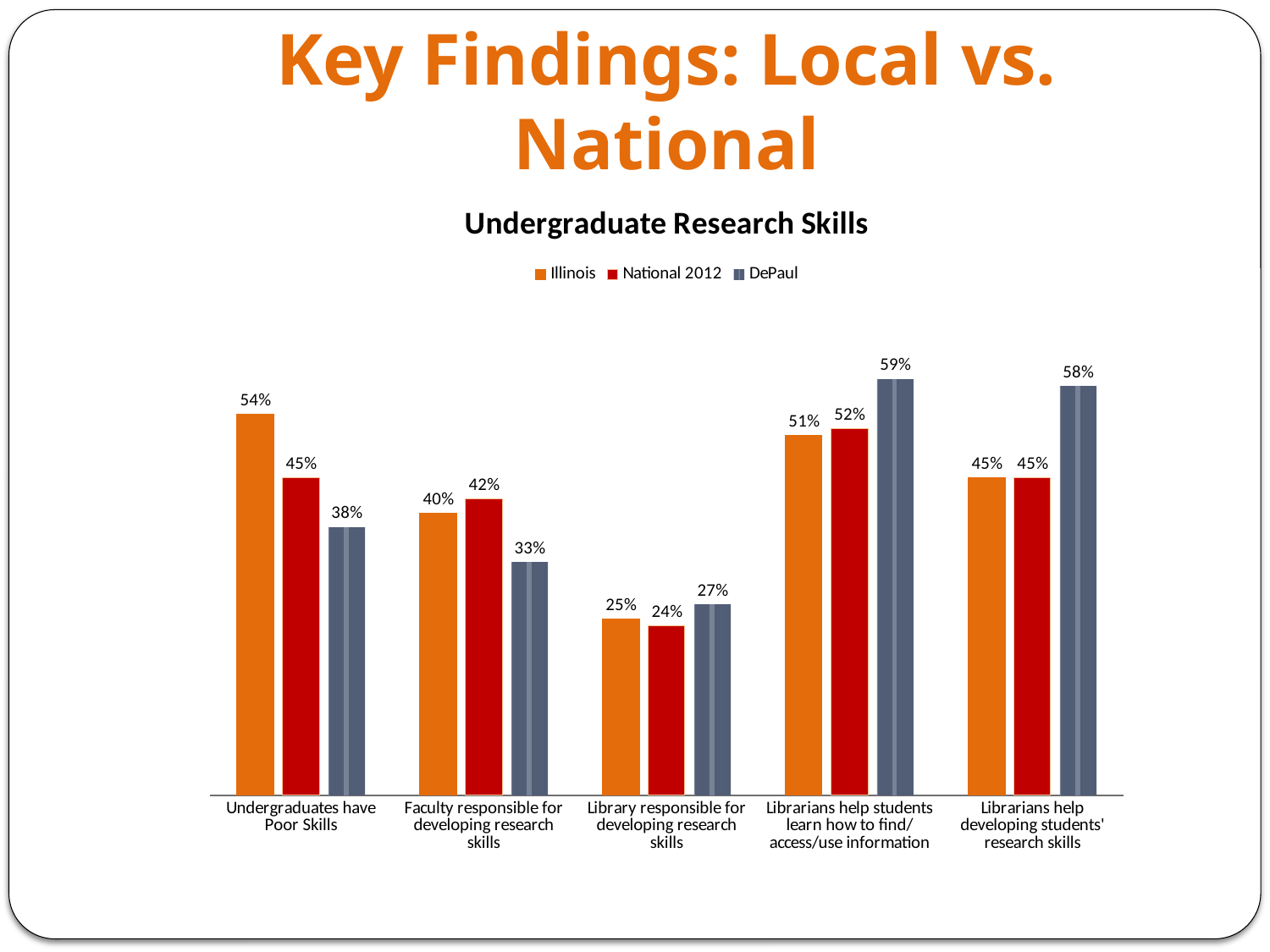
What is the National 2012 value for "Library responsible for developing research skills"? 24% How many series does the legend list? 3 Which category has the highest DePaul value? Librarians help students learn how to find/access/use information Which series is shown in orange? Illinois How many categories are shown on the x axis? 5 What is the Illinois value for "Undergraduates have Poor Skills"? 54% For "Faculty responsible for developing research skills", which is larger: the National 2012 value or the DePaul value? National 2012 What is the DePaul value for "Librarians help students learn how to find/access/use information"? 59% What is the title of the chart? Undergraduate Research Skills Which category has the lowest Illinois value? Library responsible for developing research skills What kind of chart is shown on the slide? Bar chart What is the difference between the Illinois and DePaul values for "Undergraduates have Poor Skills"? 16%